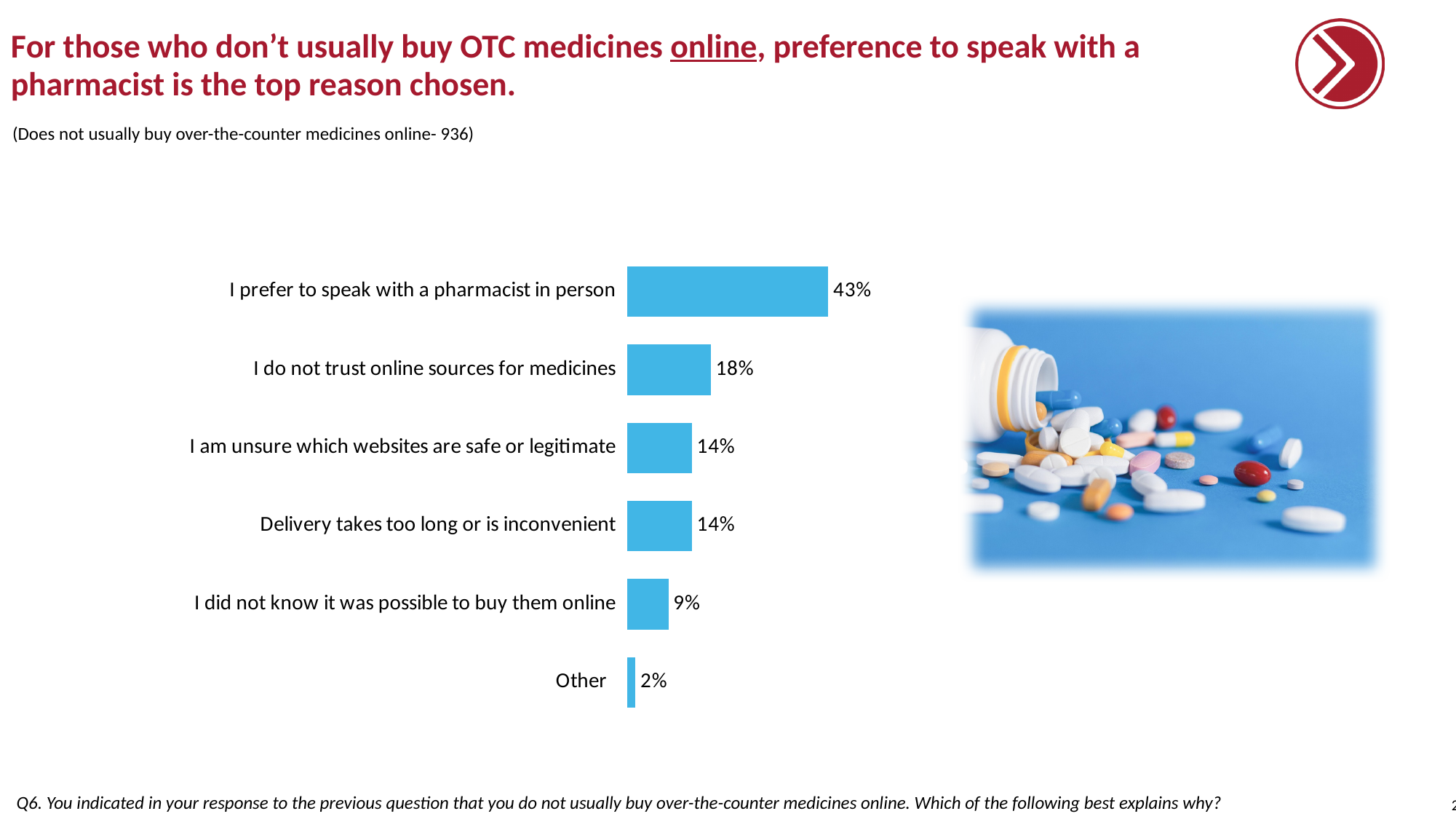
What percentage of respondents chose "I prefer to speak with a pharmacist in person"? 43% Which reason has the highest percentage? I prefer to speak with a pharmacist in person Which reason has the lowest percentage? Other What colour are the bars in the chart? Blue Which is larger: the value for "I do not trust online sources for medicines" or the value for "I did not know it was possible to buy them online"? I do not trust online sources for medicines What kind of chart is shown on the slide? Bar chart What percentage of respondents chose "I did not know it was possible to buy them online"? 9% What percentage of respondents chose "I do not trust online sources for medicines"? 18% How many reason categories are shown in the chart? 6 What percentage of respondents chose "Other"? 2% What is the difference in percentage points between "I prefer to speak with a pharmacist in person" and "I do not trust online sources for medicines"? 25 percentage points What percentage is shown for "Delivery takes too long or is inconvenient"? 14%